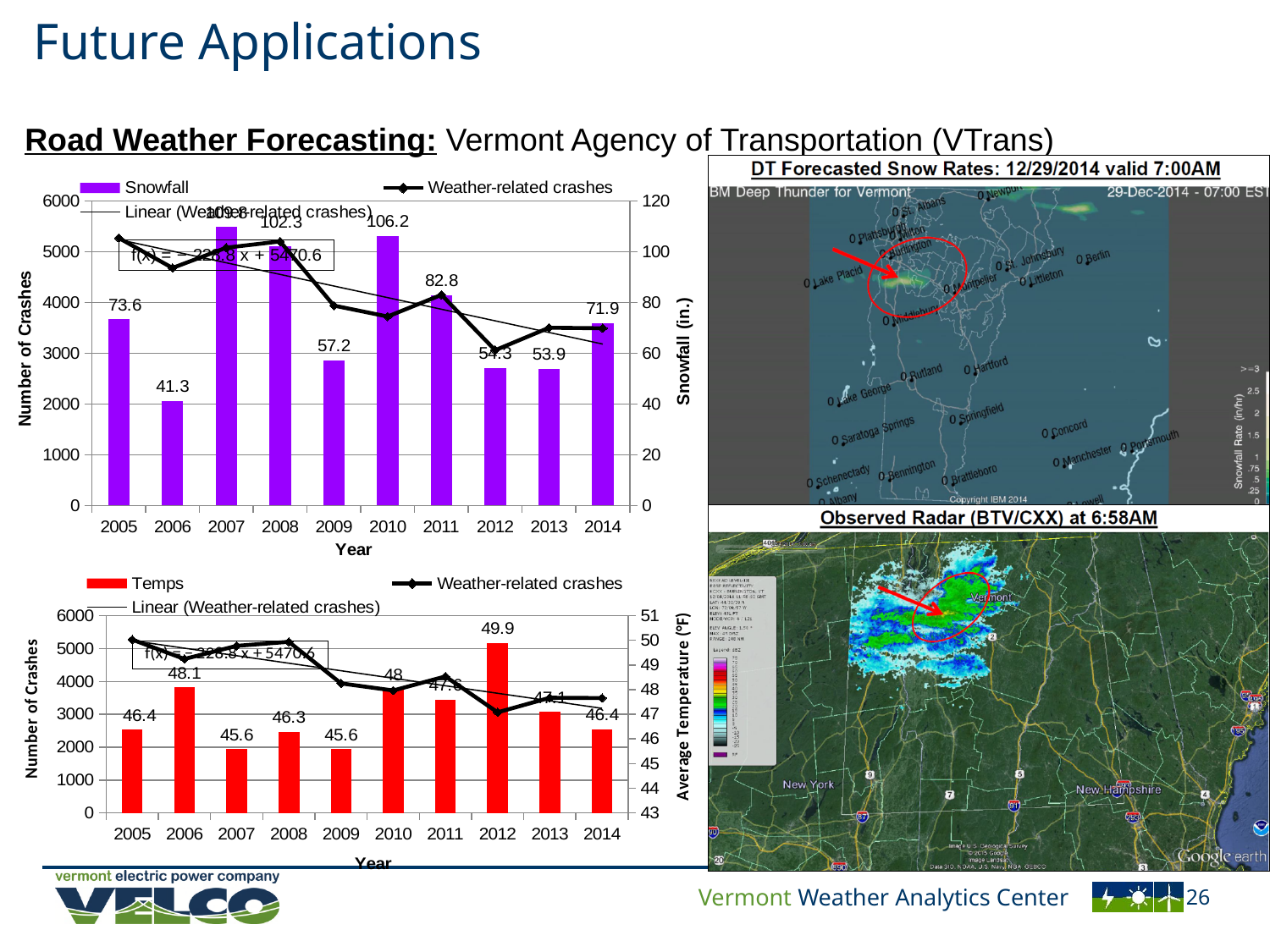
In the top chart (Snowfall vs. Weather-related crashes), what is the snowfall value for 2011? 82.8 In the top chart (Snowfall vs. Weather-related crashes), is the number of weather-related crashes in 2012 greater or less than 4000? less In the top chart (Snowfall vs. Weather-related crashes), how many years are shown on the x axis? 10 In the bottom chart (Temps vs. Weather-related crashes), what kind of chart is used for the Temps series? bar chart In the top chart (Snowfall vs. Weather-related crashes), which year has the lowest snowfall? 2006 In the top chart (Snowfall vs. Weather-related crashes), what is the snowfall value for 2006? 41.3 In the bottom chart (Temps vs. Weather-related crashes), is the number of weather-related crashes in 2005 greater or less than 5000? greater In the top chart (Snowfall vs. Weather-related crashes), does the weather-related crashes line generally rise or fall from 2005 to 2014? fall In the top chart (Snowfall vs. Weather-related crashes), what is the difference between the snowfall in 2011 and in 2012? 28.5 In the top chart (Snowfall vs. Weather-related crashes), how many entries does the legend list? 3 In the bottom chart (Temps vs. Weather-related crashes), what is the average temperature value for 2012? 49.9 In the bottom chart (Temps vs. Weather-related crashes), which year has the highest average temperature? 2012